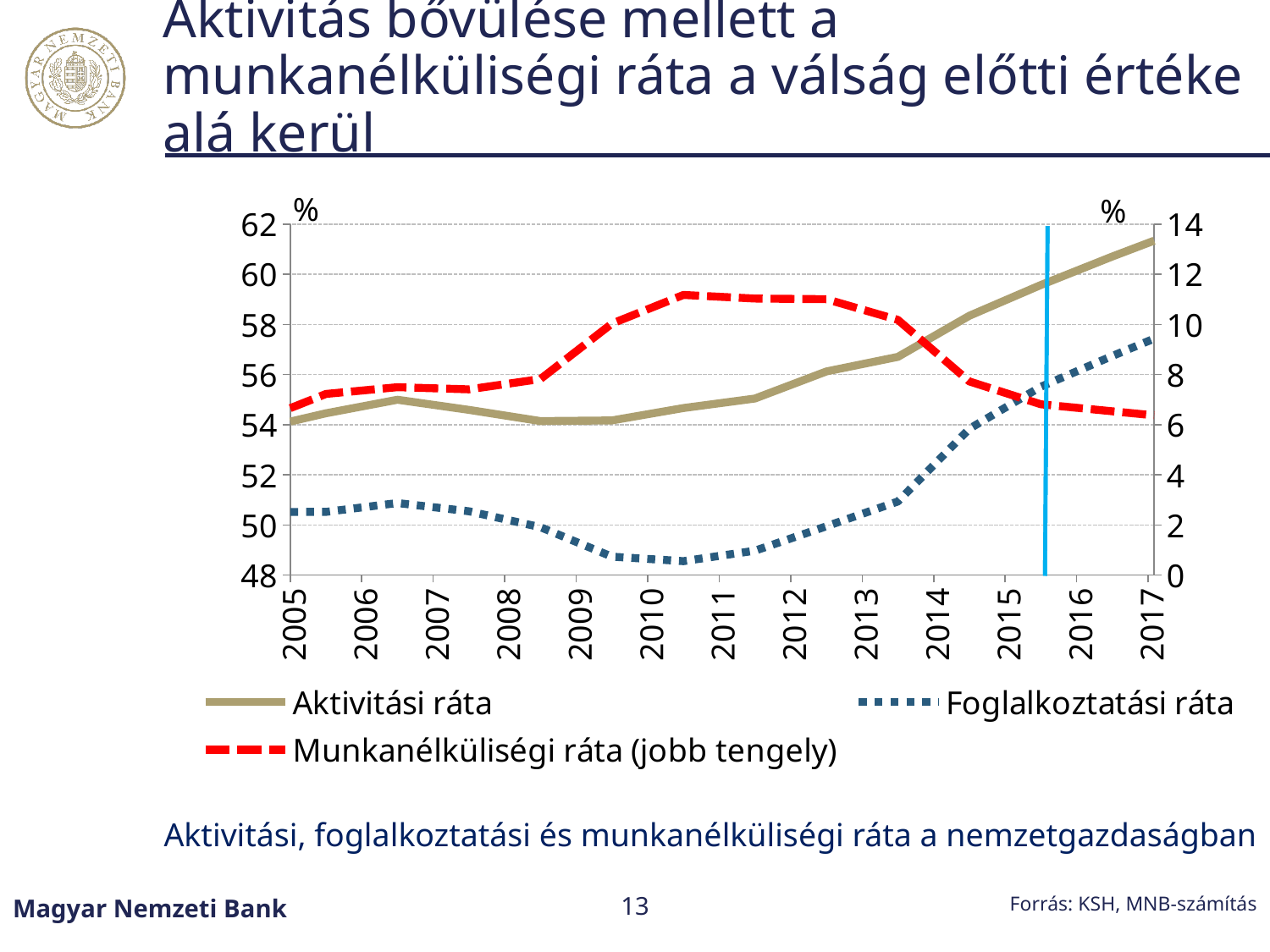
How many years are labelled on the x axis? 13 What is the caption below the chart? Aktivitási, foglalkoztatási és munkanélküliségi ráta a nemzetgazdaságban What kind of chart is shown on the slide? Line chart How many series does the legend list? 3 Is the value of Aktivitási ráta in 2005 greater or less than 56? less Is the value of Foglalkoztatási ráta in 2010 greater or less than 50? less Does the Munkanélküliségi ráta rise or fall between 2013 and 2017? fall Does the Aktivitási ráta rise or fall between 2013 and 2017? rise Is the value of Munkanélküliségi ráta (right axis) in 2017 greater or less than 8? less Which series is plotted on the right axis according to the legend? Munkanélküliségi ráta